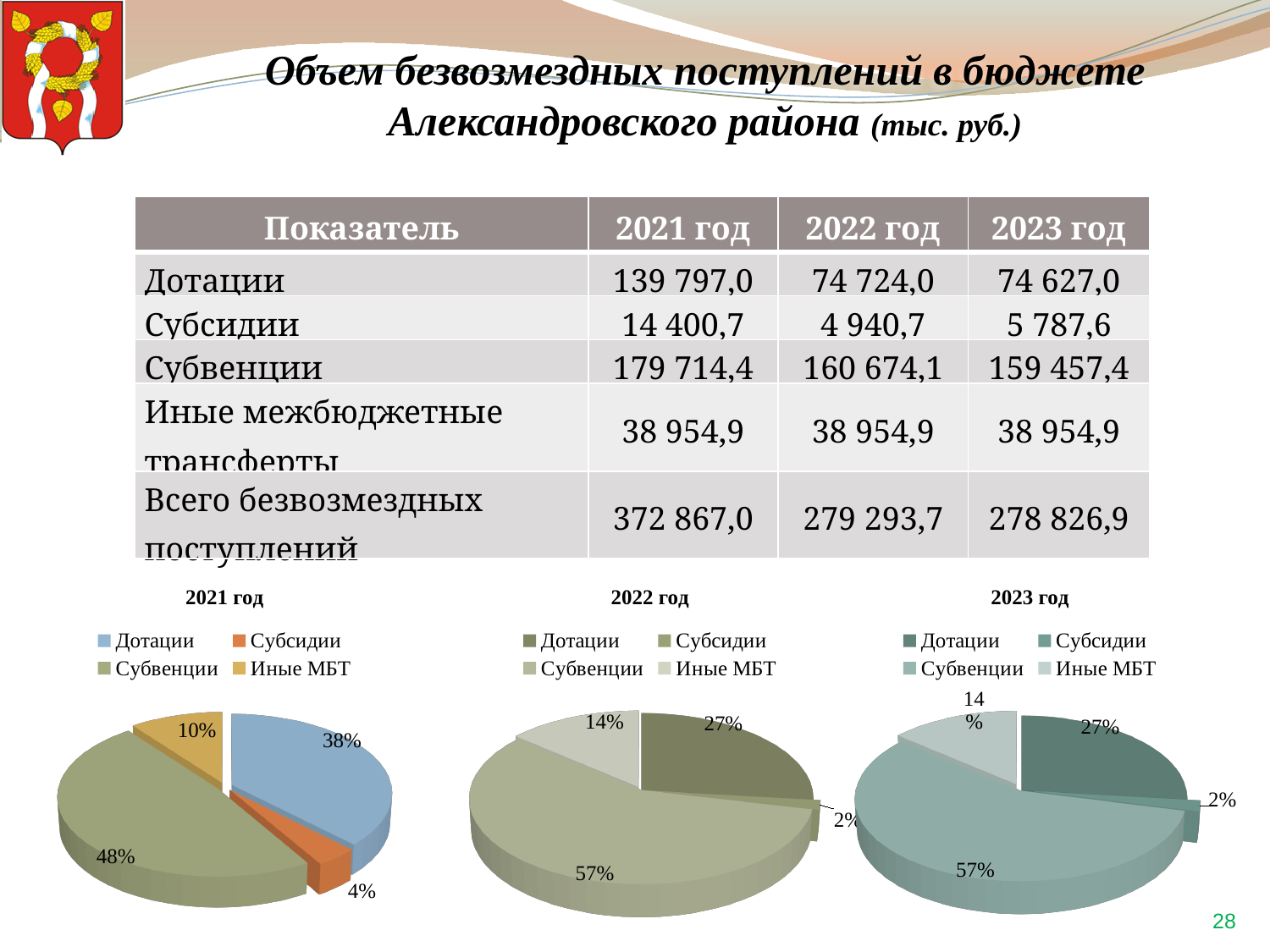
In the 2021 год pie chart, which category has the largest slice? Субвенции In the 2023 год pie chart, what share does Дотации have? 27% In the 2022 год pie chart, what share does Субсидии have? 2% What type of chart is used for 2021 год, 2022 год and 2023 год? Pie chart In the 2021 год pie chart, what is the difference between the Субвенции share and the Дотации share? 10% In the 2021 год pie chart, which category has the smallest slice? Субсидии In the 2022 год pie chart, what share does Иные МБТ have? 14% In the 2022 год pie chart, which is larger, the Дотации slice or the Иные МБТ slice? Дотации How many categories does the legend of the 2023 год pie chart list? 4